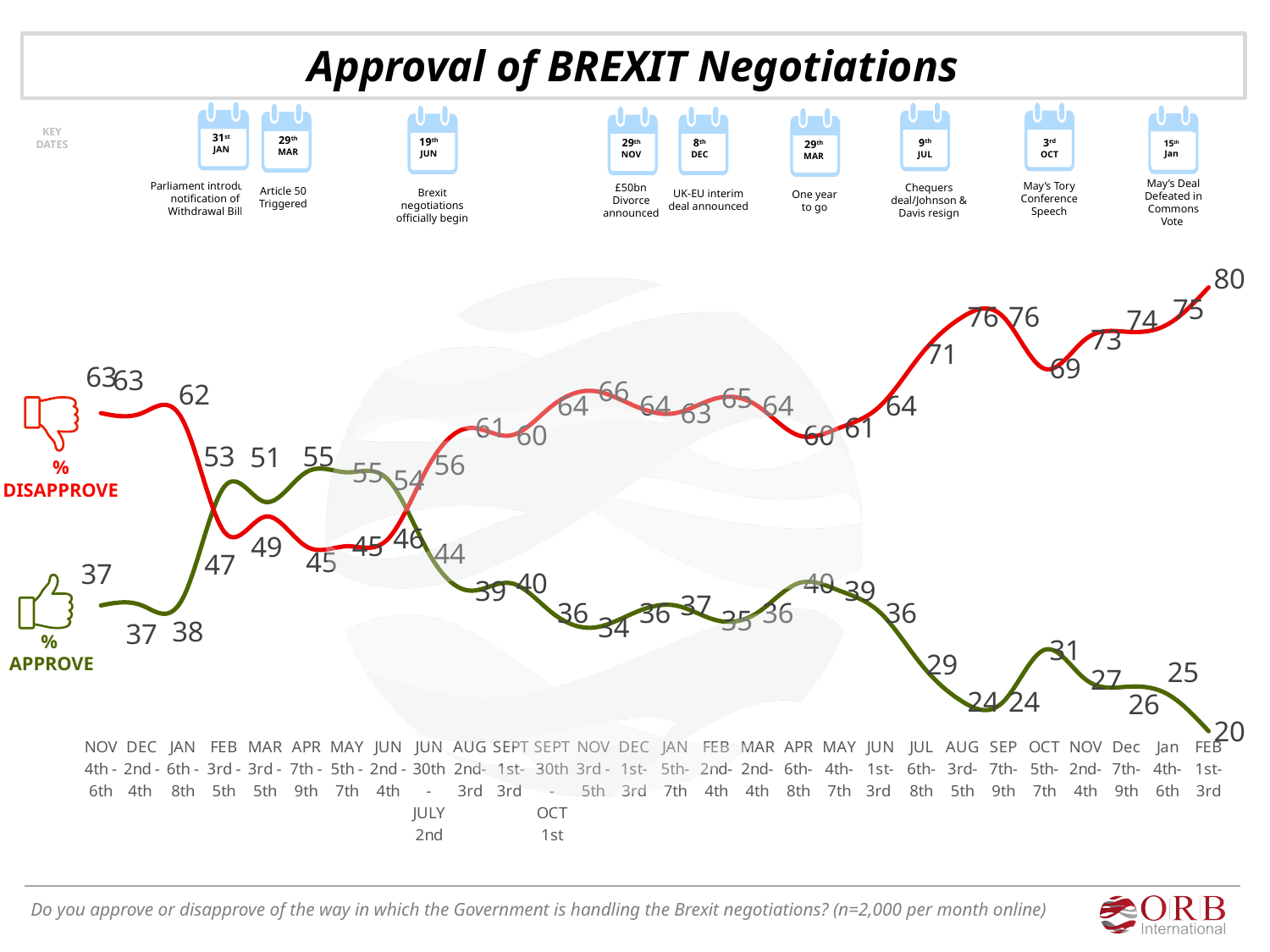
What is the highest value shown on the % APPROVE line? 55 How many series are plotted on the chart? 2 What is the % DISAPPROVE value at JUL 6th-8th? 71 What is the % DISAPPROVE value at FEB 1st-3rd, the last point on the chart? 80 What kind of chart is shown on the slide? line chart What is the lowest value shown on the % APPROVE line? 20 What is the % APPROVE value at FEB 1st-3rd, the last point on the chart? 20 What is the difference between % DISAPPROVE and % APPROVE at FEB 1st-3rd, the last point? 60 At NOV 4th-6th, the first point, which is larger: % DISAPPROVE or % APPROVE? % DISAPPROVE Does the % DISAPPROVE line rise or fall from JUN 1st-3rd to AUG 3rd-5th? rise At which survey period does the % DISAPPROVE line reach its highest value? FEB 1st-3rd What is the % APPROVE value at OCT 5th-7th? 31